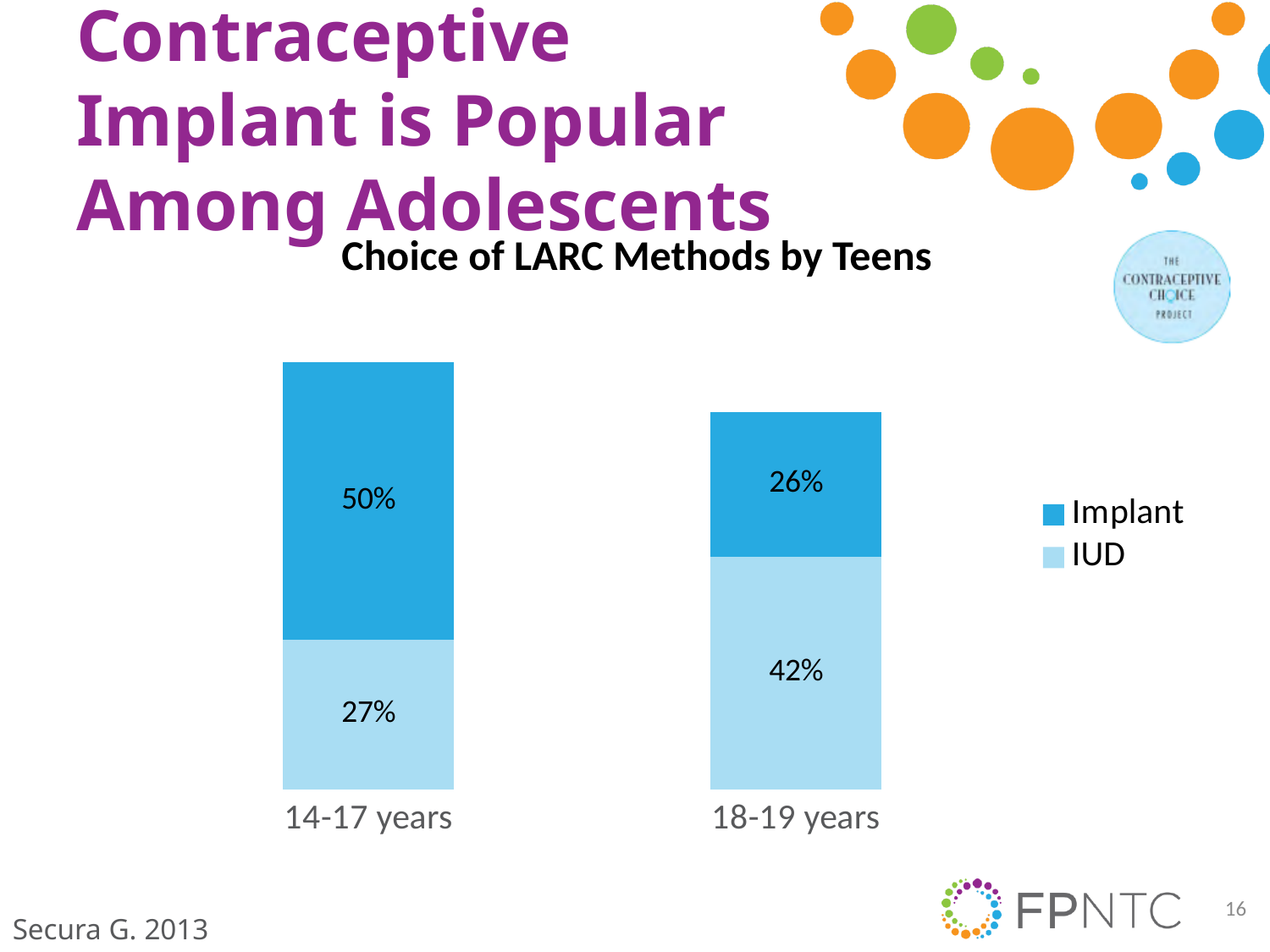
What is the Implant value for the 18-19 years group? 26% What is the IUD value for the 18-19 years group? 42% What is the total of the stacked bar for 14-17 years? 77% What is the Implant value for the 14-17 years group? 50% What is the total of the stacked bar for 18-19 years? 68% Which age group has the higher Implant value? 14-17 years Which age group has the lower IUD value? 14-17 years What is the difference between the Implant values for 14-17 years and 18-19 years? 24% What is the IUD value for the 14-17 years group? 27% Is the IUD value larger for 14-17 years or 18-19 years? 18-19 years What is the title of the chart? Choice of LARC Methods by Teens How many series does the legend list? 2